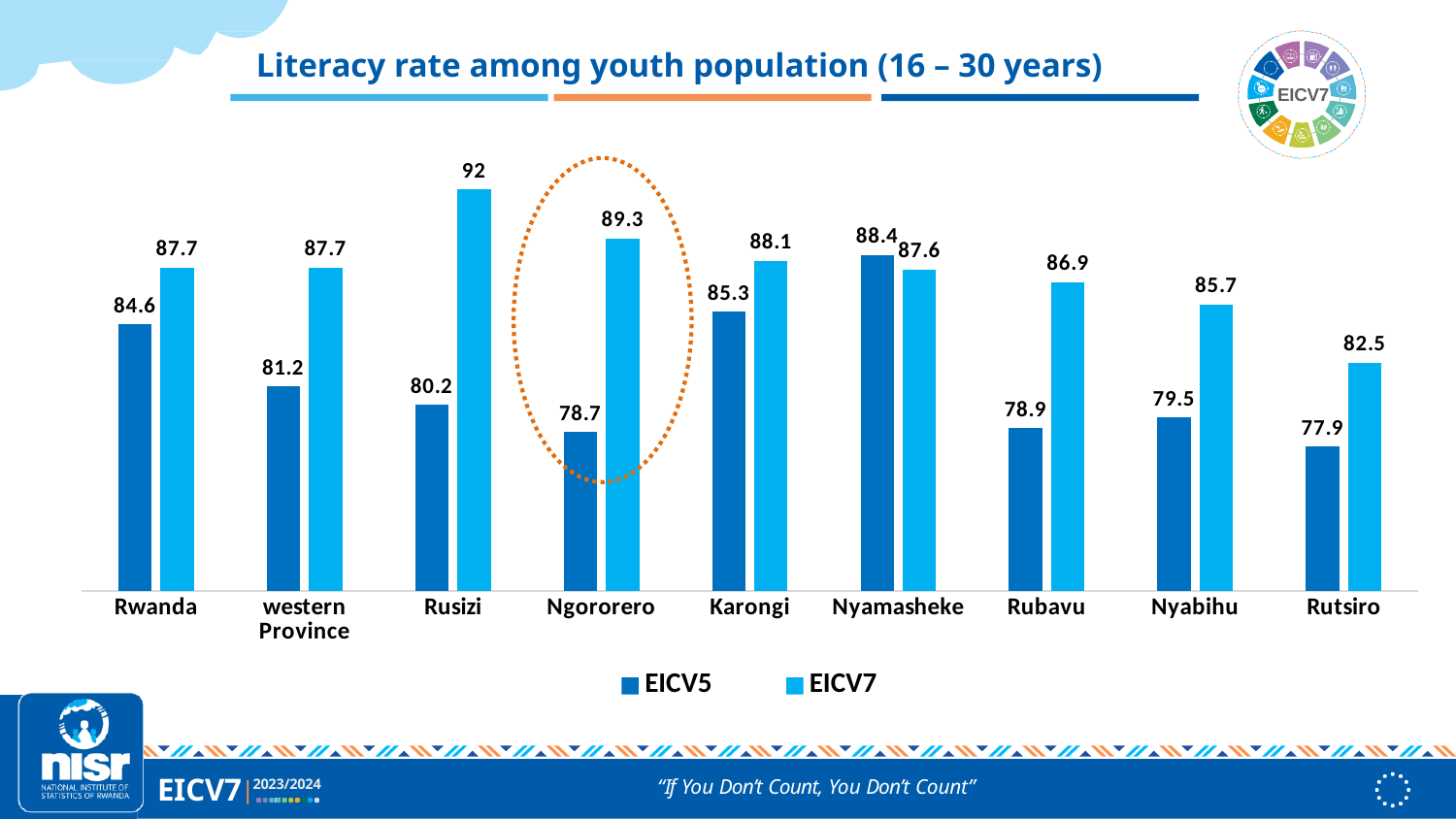
What is the EICV5 literacy rate for Ngororero? 78.7 How many categories are shown on the x axis? 9 Which category has the lowest EICV5 literacy rate? Rutsiro How many series does the legend list? 2 Which category has the highest EICV5 literacy rate? Nyamasheke What kind of chart is shown on the slide? Bar chart Which district has the highest EICV7 literacy rate? Rusizi For Nyamasheke, which is larger, the EICV5 value or the EICV7 value? EICV5 What is the difference between the EICV7 and EICV5 literacy rates for Rusizi? 11.8 What is the EICV7 literacy rate for Rusizi? 92 What is the difference between the EICV7 and EICV5 values for Ngororero? 10.6 What is the EICV7 value for Rutsiro? 82.5